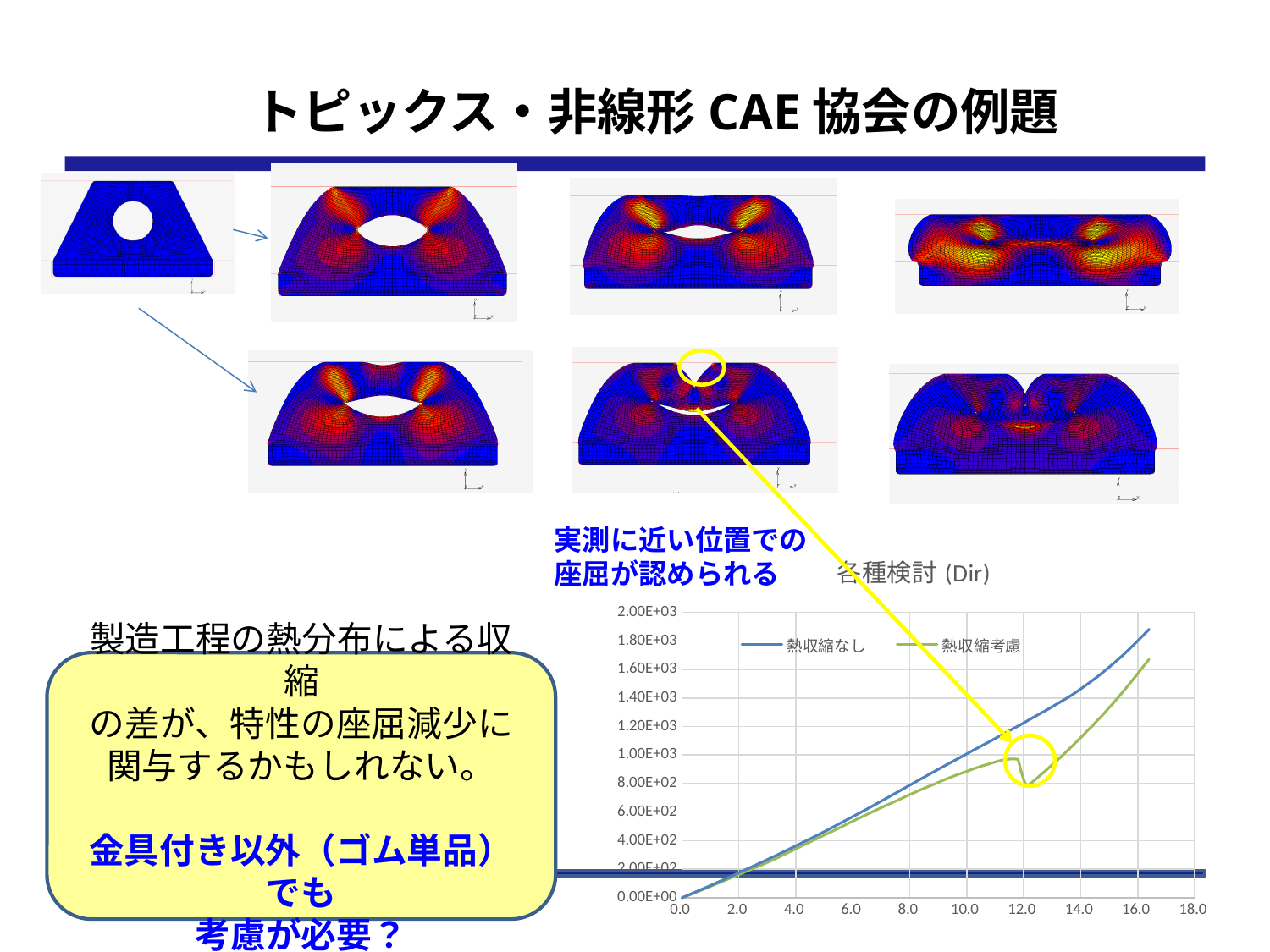
What kind of chart is shown on the slide? line chart Which series shows a sudden drop near x = 12.0? 熱収縮考慮 What is the title of the chart? 各種検討 (Dir) Does the 熱収縮なし series rise or fall as the x value increases? rise What is the highest value shown on the chart's y axis? 2.00E+03 At the right end of the chart, which series reaches the higher value? 熱収縮なし What are the two series named in the chart legend? 熱収縮なし and 熱収縮考慮 Is the value of 熱収縮なし at x = 12.0 greater or less than 8.00E+02? greater At x = 14.0, which series has the larger value, 熱収縮なし or 熱収縮考慮? 熱収縮なし Is the value of 熱収縮考慮 at x = 12.0 greater or less than 1.00E+03? less How many series does the chart legend list? 2 Is the value of 熱収縮なし at x = 16.0 greater or less than 1.60E+03? greater